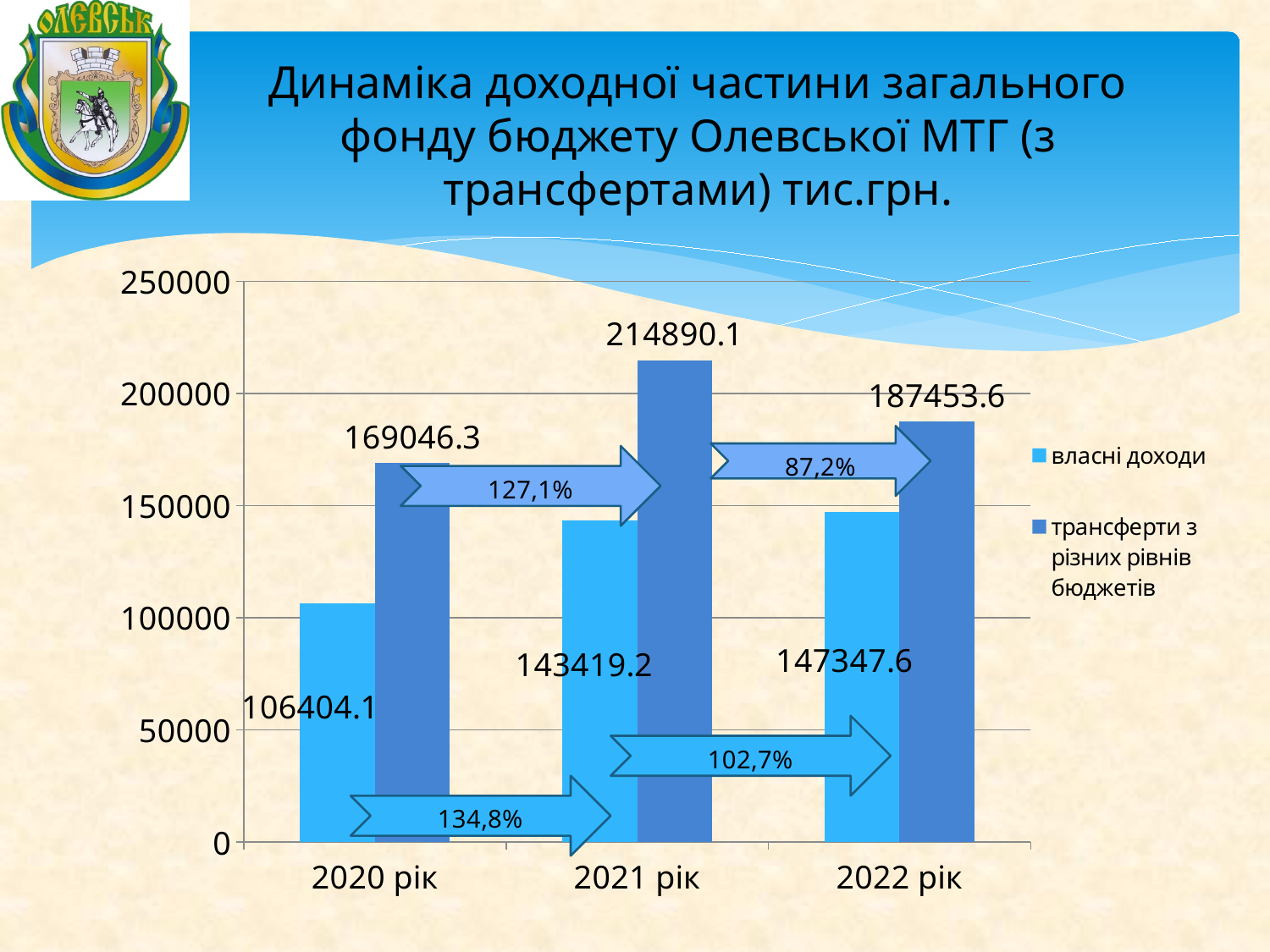
How many series does the legend list? 2 What is the value of трансферти з різних рівнів бюджетів for 2021 рік? 214890.1 Which is larger in 2022 рік: власні доходи or трансферти з різних рівнів бюджетів? трансферти з різних рівнів бюджетів In which year is the value of трансферти з різних рівнів бюджетів highest? 2021 рік What is the value of власні доходи for 2020 рік? 106404.1 What is the value of власні доходи for 2022 рік? 147347.6 What kind of chart is shown on the slide? bar chart How many years are shown on the x axis? 3 Is the value of власні доходи for 2021 рік greater or less than 150000? less What is the difference between трансферти з різних рівнів бюджетів in 2021 рік and in 2020 рік? 45843.8 What is the value of трансферти з різних рівнів бюджетів for 2022 рік? 187453.6 In which year is the value of власні доходи lowest? 2020 рік